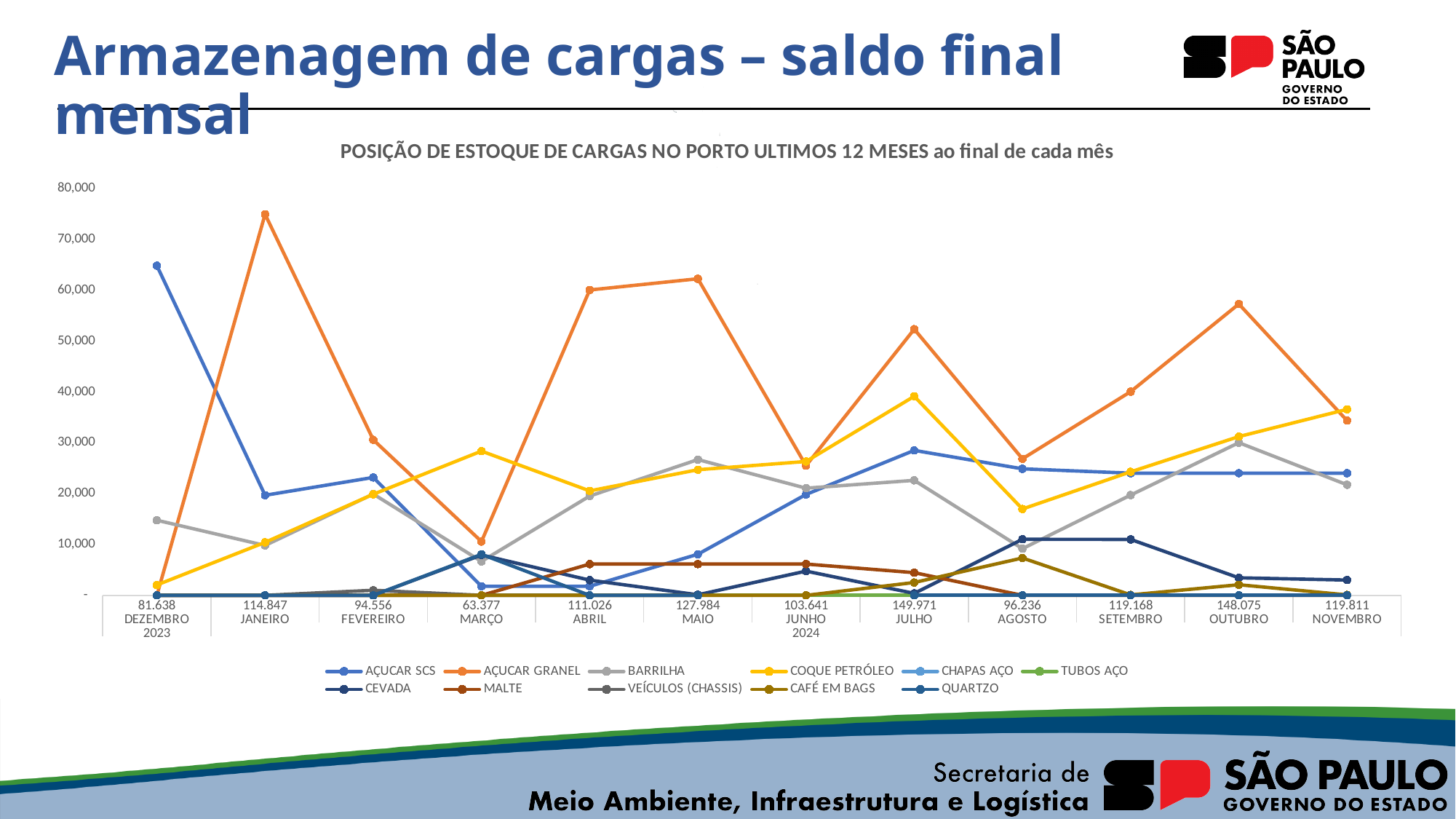
What is the title of the chart? POSIÇÃO DE ESTOQUE DE CARGAS NO PORTO ULTIMOS 12 MESES ao final de cada mês How many series does the legend list? 11 Which series reaches the highest value anywhere on the chart? AÇUCAR GRANEL Does the AÇUCAR SCS line rise or fall from DEZEMBRO 2023 to MARÇO? fall In DEZEMBRO 2023, which is larger: AÇUCAR SCS or AÇUCAR GRANEL? AÇUCAR SCS Is the value for AÇUCAR GRANEL in MARÇO greater or less than 20,000? less In which month does AÇUCAR GRANEL reach its highest value? JANEIRO How many months are shown along the x axis? 12 Is the value for AÇUCAR GRANEL in JANEIRO greater or less than 70,000? greater What kind of chart is shown on the slide? line chart Is the value for AÇUCAR SCS in DEZEMBRO 2023 greater or less than 60,000? greater In OUTUBRO, which is larger: AÇUCAR GRANEL or COQUE PETRÓLEO? AÇUCAR GRANEL